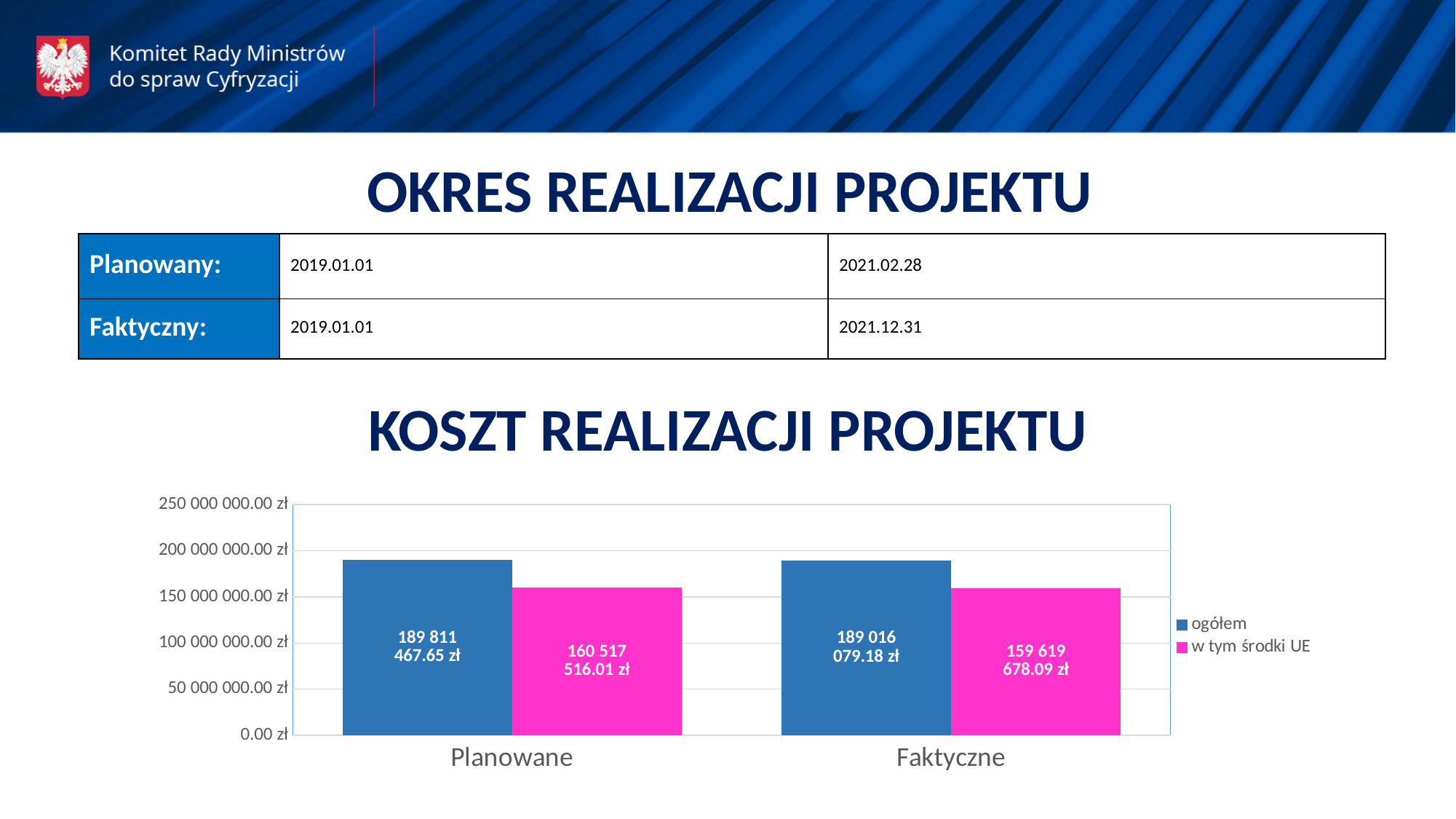
Which colour represents the series w tym środki UE? pink What is the value of ogółem for Planowane? 189 811 467.65 zł How many categories are shown on the x axis? 2 What is the difference between ogółem and w tym środki UE for Planowane? 29 293 951.64 zł Which is larger: ogółem for Planowane or ogółem for Faktyczne? ogółem for Planowane Is the value of w tym środki UE for Faktyczne greater or less than 200 000 000.00 zł? less What is the value of w tym środki UE for Planowane? 160 517 516.01 zł What kind of chart is shown under the title KOSZT REALIZACJI PROJEKTU? bar chart How many series does the legend list? 2 What is the difference between w tym środki UE for Planowane and w tym środki UE for Faktyczne? 897 837.92 zł What is the value of ogółem for Faktyczne? 189 016 079.18 zł What is the value of w tym środki UE for Faktyczne? 159 619 678.09 zł